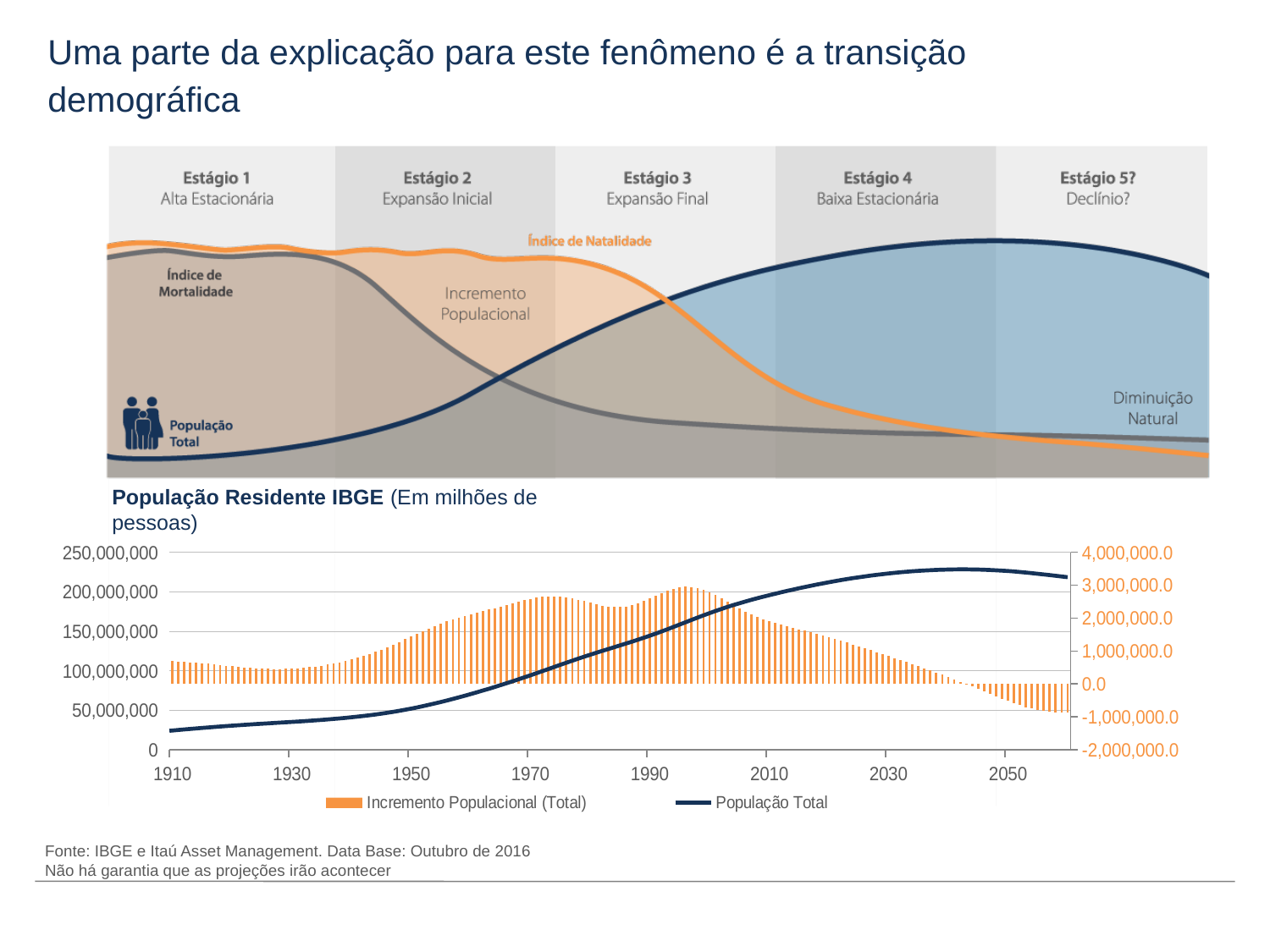
In the bottom chart 'População Residente IBGE', is the value of População Total in 1910 greater or less than 50,000,000? less In the bottom chart 'População Residente IBGE', does População Total rise or fall between 1910 and 2030? rise In the bottom chart 'População Residente IBGE', is the value of População Total in 1930 greater or less than 50,000,000? less In the bottom chart 'População Residente IBGE', is the value of Incremento Populacional (Total) in 1910 greater or less than 1,000,000.0? less In the bottom chart 'População Residente IBGE', what are the two series named in the legend? Incremento Populacional (Total) and População Total In the bottom chart 'População Residente IBGE', what kind of chart is used to show 'Incremento Populacional (Total)'? bar chart In the bottom chart 'População Residente IBGE', how many series does the legend list? 2 In the bottom chart 'População Residente IBGE', what kind of chart is used to show 'População Total'? line chart In the bottom chart 'População Residente IBGE', does Incremento Populacional (Total) rise or fall between 2000 and 2060? fall